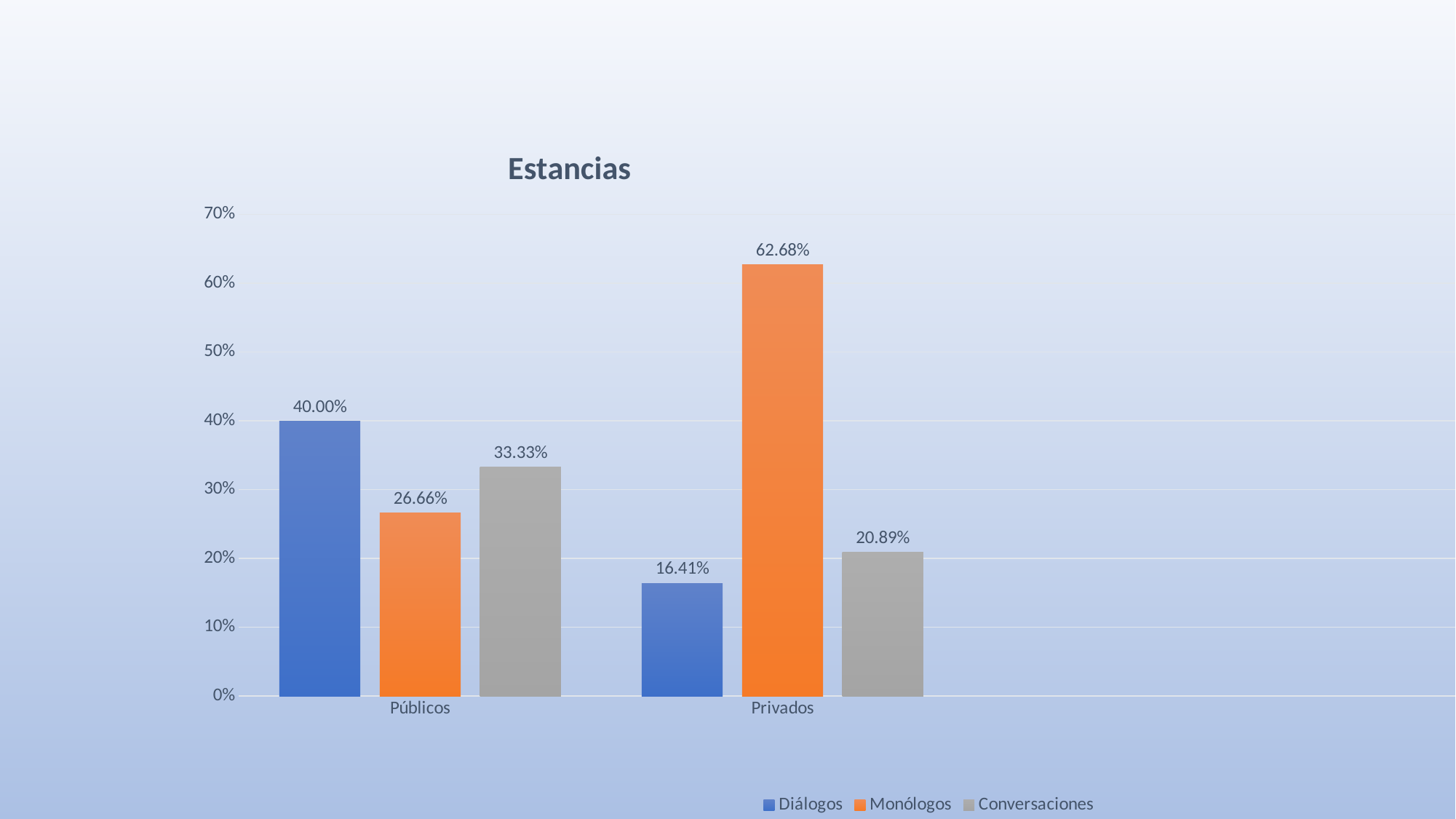
What is the value for Diálogos in the Privados category? 16.41% How many categories are shown on the x axis? 2 Which series has the highest value in the Privados category? Monólogos What is the value for Monólogos in the Privados category? 62.68% Which series has the lowest value in the Públicos category? Monólogos What is the difference between the Monólogos values for Privados and Públicos? 36.02% What is the value for Diálogos in the Públicos category? 40.00% What is the value for Conversaciones in the Públicos category? 33.33% What is the title of the chart? Estancias How many series does the legend list? 3 Which is larger: Conversaciones for Públicos or Conversaciones for Privados? Públicos What kind of chart is shown on the slide? Bar chart